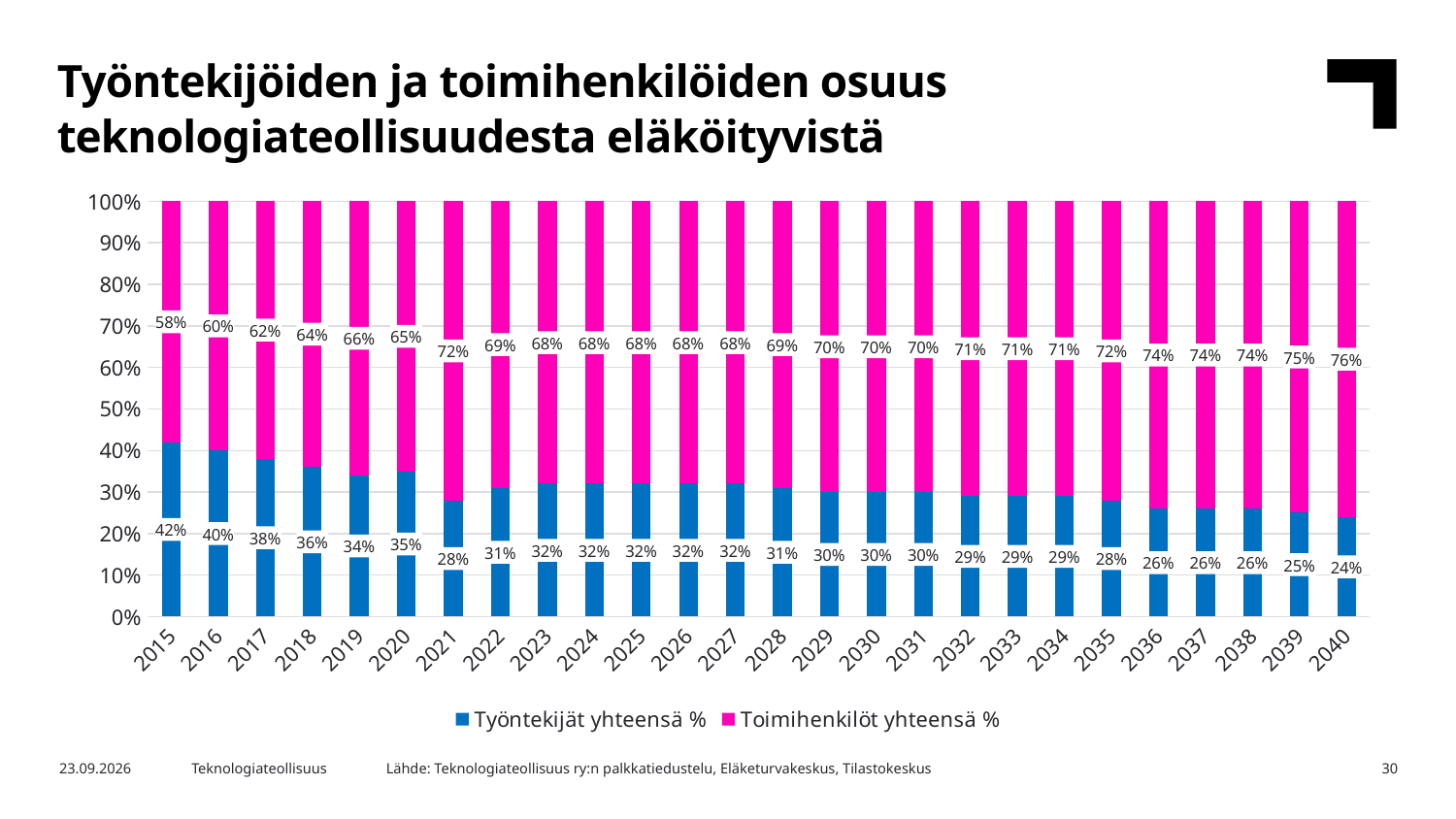
What is the value for Työntekijät yhteensä % in 2015? 42% What is the value for Toimihenkilöt yhteensä % in 2040? 76% What is the value for Työntekijät yhteensä % in 2021? 28% In which year is the Työntekijät yhteensä % share lowest? 2040 Which is larger in 2019: Työntekijät yhteensä % or Toimihenkilöt yhteensä %? Toimihenkilöt yhteensä % In which year is the Työntekijät yhteensä % share highest? 2015 Does the Toimihenkilöt yhteensä % share generally rise or fall from 2015 to 2040? Rise What kind of chart is shown on the slide? Stacked bar chart What is the total of the stacked bar for 2030? 100% How many series does the legend list? 2 What is the difference between the Toimihenkilöt yhteensä % values for 2040 and 2015? 18 percentage points How many years are shown on the x axis? 26